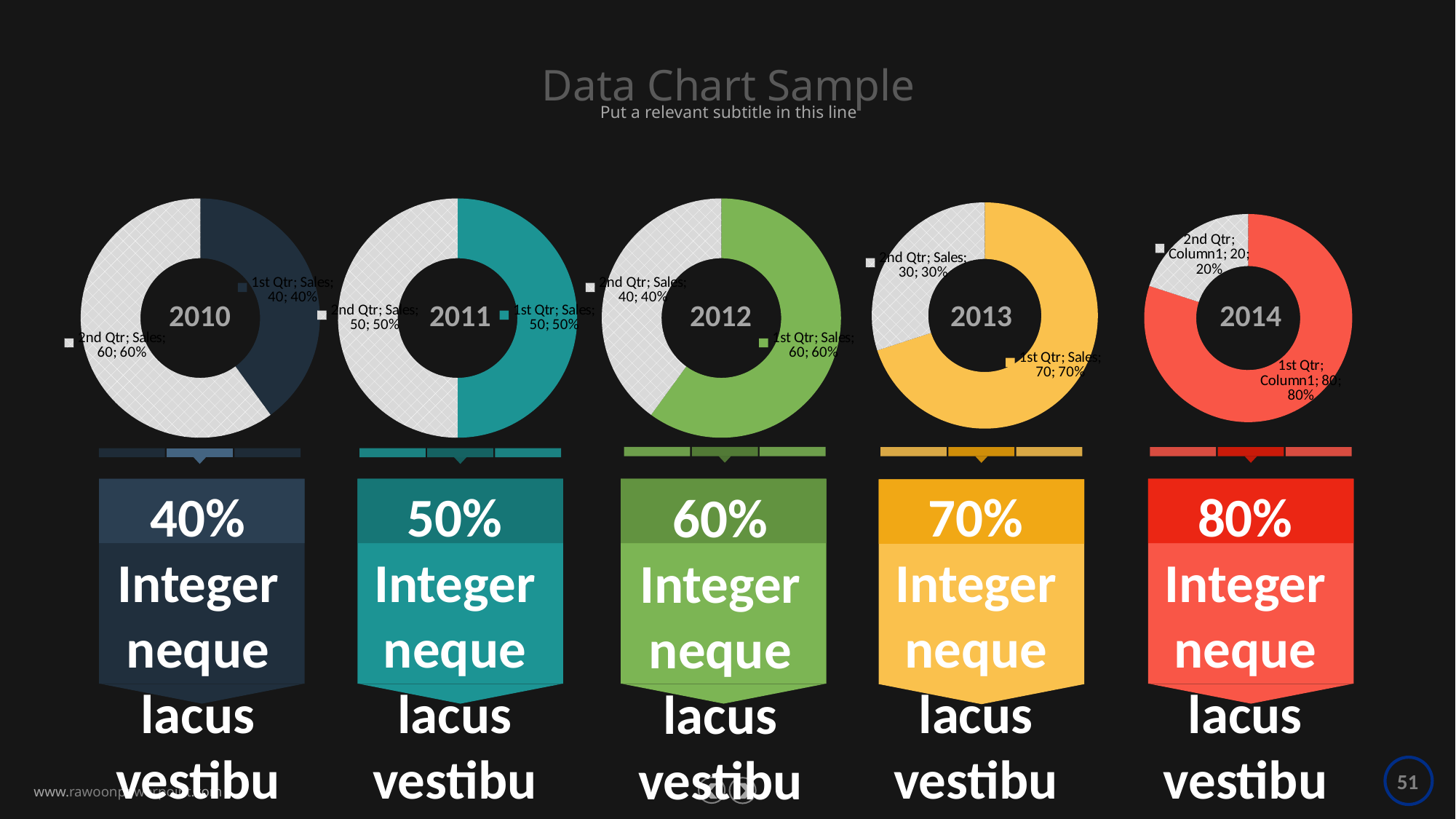
In the 2011 doughnut chart, what is the value for 2nd Qtr? 50 In the 2014 doughnut chart, which slice is the smallest? 2nd Qtr In the 2010 doughnut chart, what share of the whole does the 2nd Qtr slice represent? 60% In the 2010 doughnut chart, what is the value for 1st Qtr? 40 In the 2013 doughnut chart, what share of the whole does the 1st Qtr slice represent? 70% How many slices does the 2011 doughnut chart have? 2 What type of chart is used for the 2010 chart? Doughnut chart In the 2014 doughnut chart, what is the value for 1st Qtr? 80 How many doughnut charts are shown on the slide? 5 In the 2012 doughnut chart, what is the difference between the 1st Qtr and 2nd Qtr values? 20 In the 2013 doughnut chart, what is the value for 2nd Qtr? 30 In the 2012 doughnut chart, which slice is larger, 1st Qtr or 2nd Qtr? 1st Qtr